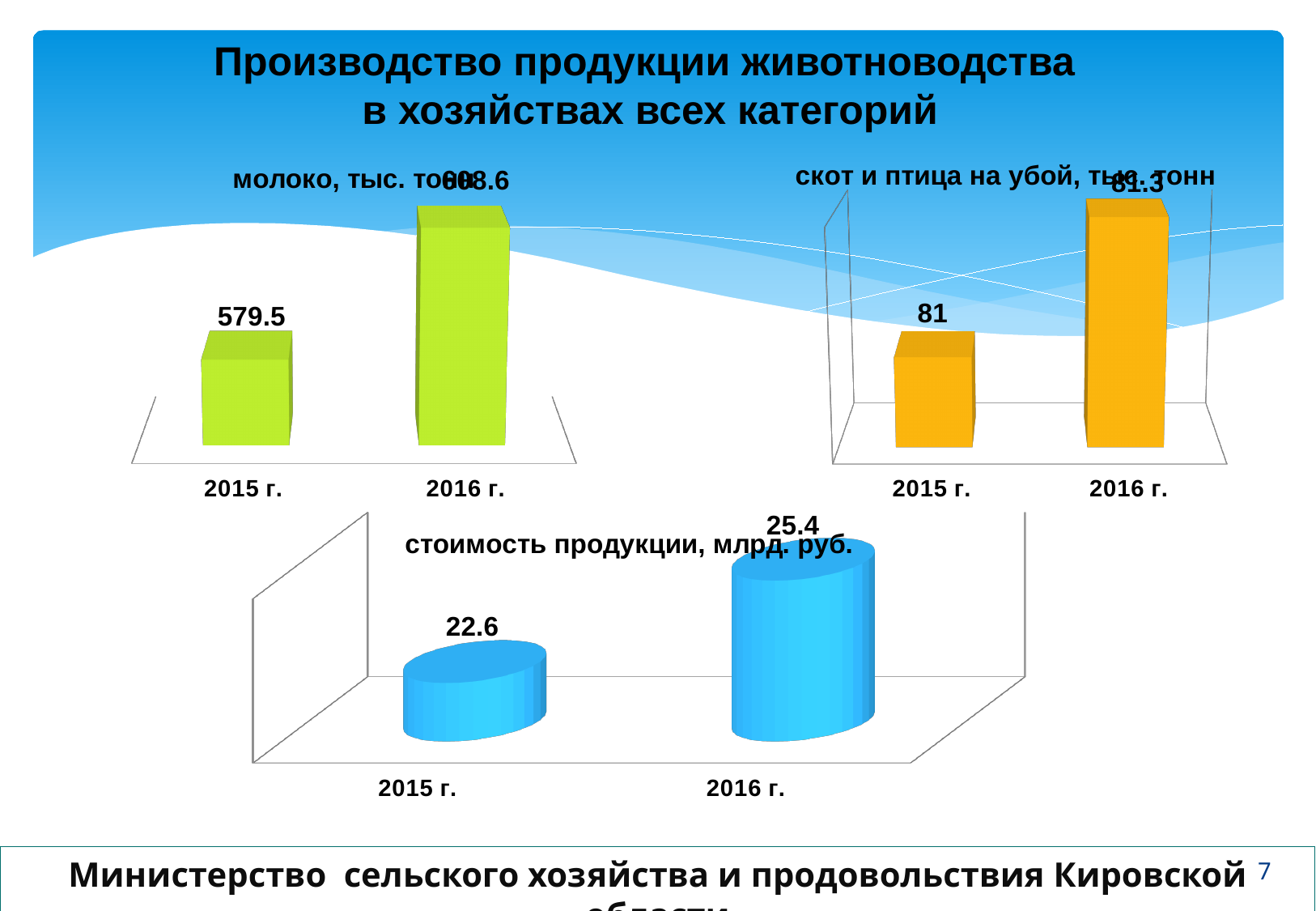
In the chart titled "стоимость продукции, млрд. руб.", what is the value for 2015 г.? 22.6 In the chart titled "стоимость продукции, млрд. руб.", which year has the higher value? 2016 г. What kind of chart is the one titled "молоко, тыс. тонн"? bar chart In the chart titled "стоимость продукции, млрд. руб.", do the values rise or fall from 2015 г. to 2016 г.? rise In the chart titled "молоко, тыс. тонн", what is the value for 2015 г.? 579.5 In the chart titled "стоимость продукции, млрд. руб.", what is the difference between the 2016 г. and 2015 г. values? 2.8 In the chart titled "стоимость продукции, млрд. руб.", what is the value for 2016 г.? 25.4 In the chart titled "молоко, тыс. тонн", which year has the higher value? 2016 г. In the chart titled "скот и птица на убой, тыс. тонн", what is the value for 2015 г.? 81 In the chart titled "молоко, тыс. тонн", how many categories are plotted? 2 How many charts are shown on the slide? 3 In the chart titled "скот и птица на убой, тыс. тонн", how many categories are plotted? 2